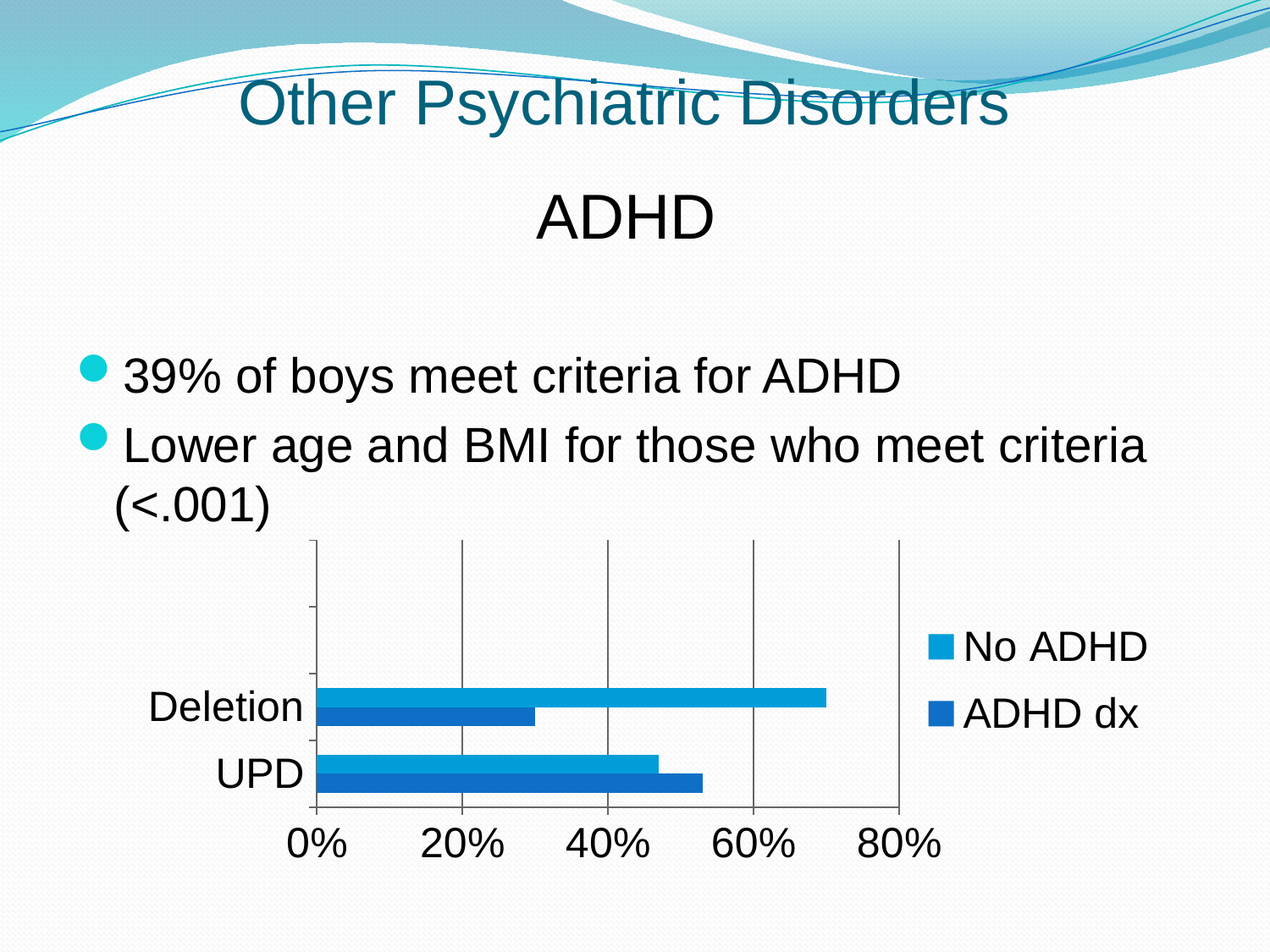
Which category has the higher No ADHD value, Deletion or UPD? Deletion Is the ADHD dx value for Deletion greater or less than 40%? less For Deletion, which series has the larger value, No ADHD or ADHD dx? No ADHD Is the No ADHD value for UPD greater or less than 40%? greater Which category has the higher ADHD dx value, Deletion or UPD? UPD How many series does the chart's legend list? 2 Is the No ADHD value for Deletion greater or less than 60%? greater How many categories are shown on the chart's vertical axis? 2 What are the two series named in the chart's legend? No ADHD and ADHD dx What is the highest percentage tick shown on the chart's horizontal axis? 80% What kind of chart is shown on the slide? bar chart